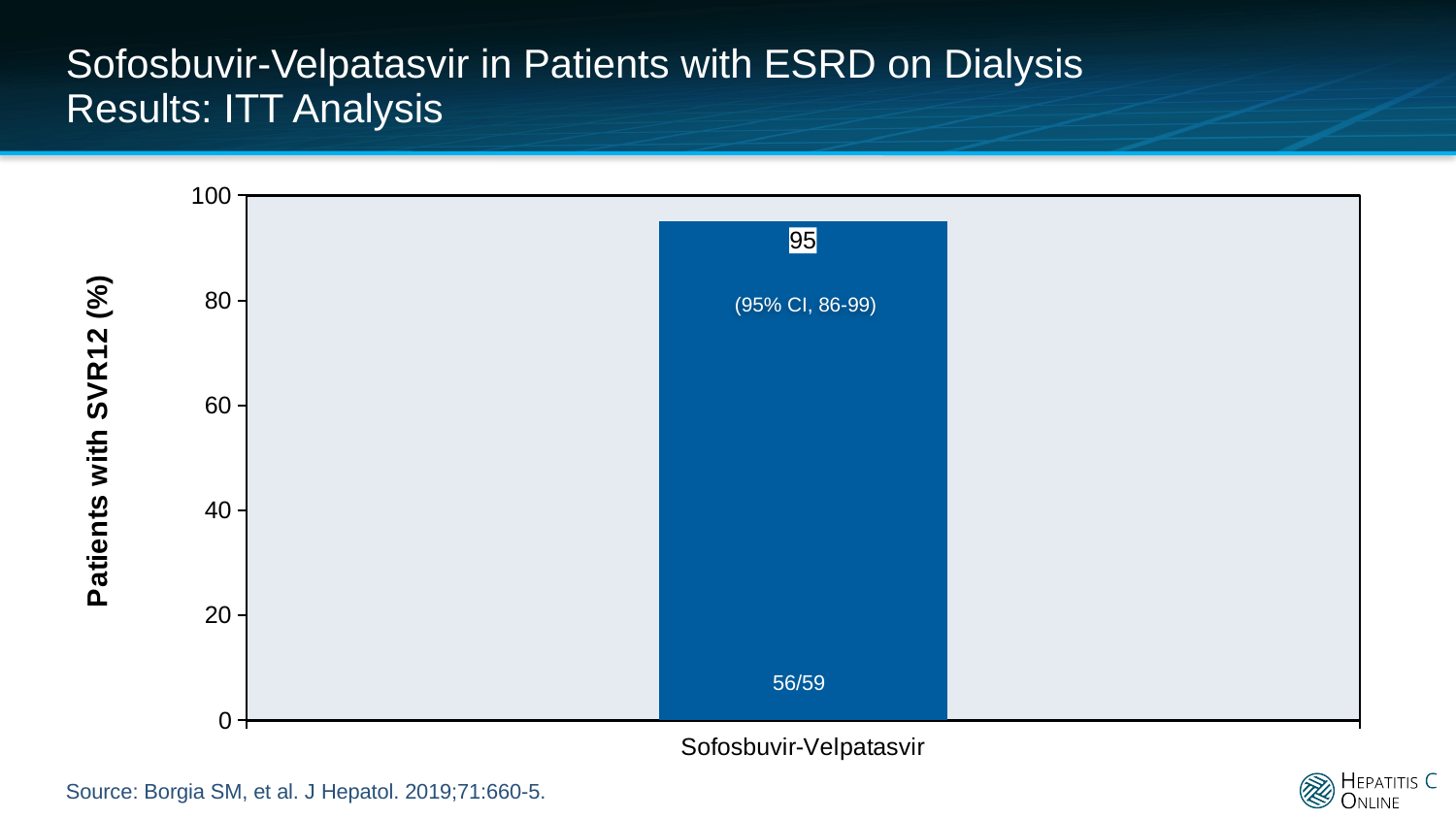
What is the label of the y axis? Patients with SVR12 (%) What kind of chart is shown on the slide? bar chart What fraction of patients is shown on the Sofosbuvir-Velpatasvir bar? 56/59 What is the label of the category on the x axis? Sofosbuvir-Velpatasvir Is the value for Sofosbuvir-Velpatasvir greater or less than 100? less What is the maximum value shown on the y axis? 100 How many categories are plotted on the chart? 1 Is the value for Sofosbuvir-Velpatasvir greater or less than 80? greater What is the 95% confidence interval shown for Sofosbuvir-Velpatasvir? 86-99 What is the value for Sofosbuvir-Velpatasvir? 95